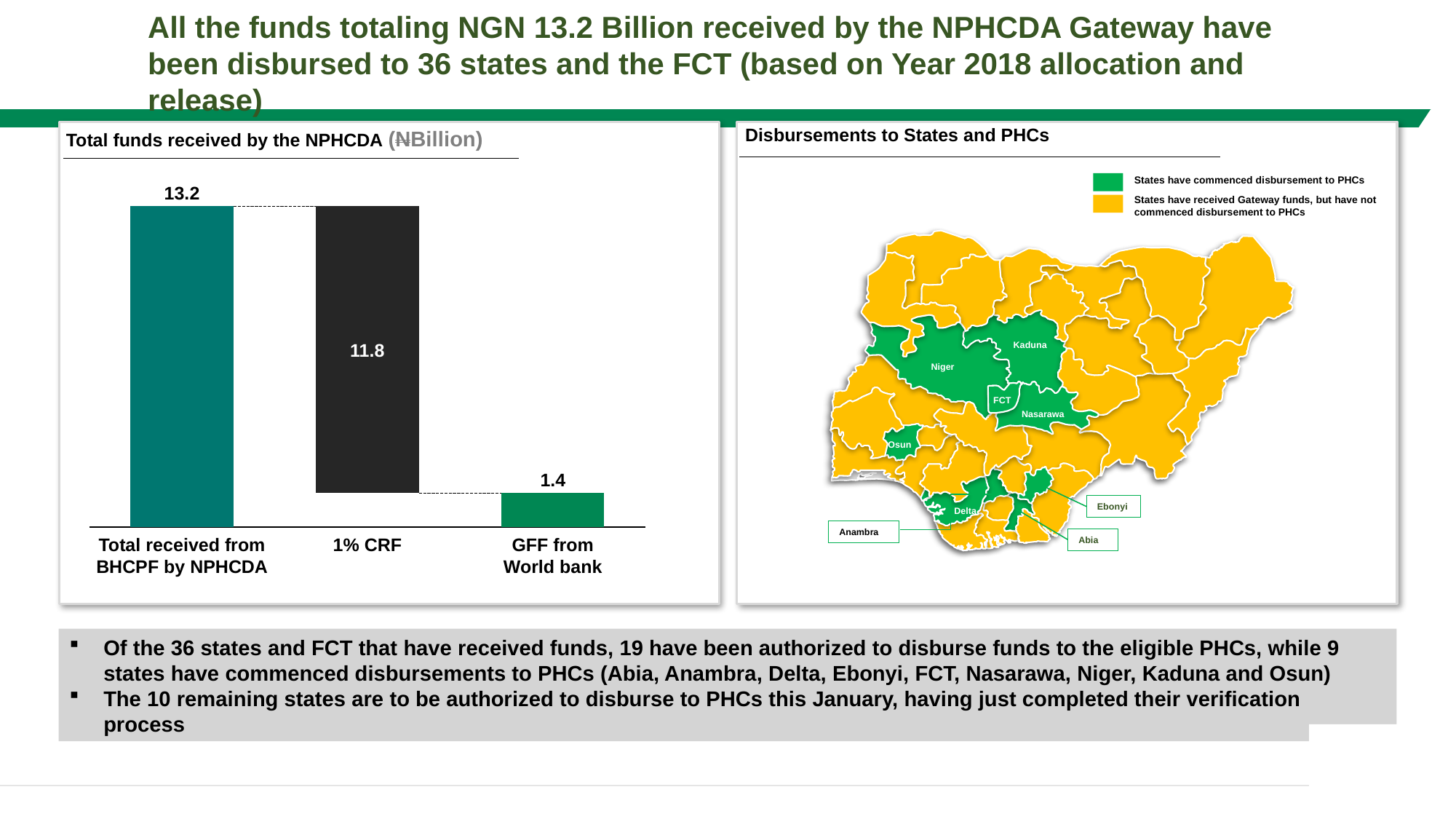
In the 'Total funds received by the NPHCDA' chart, do the values rise or fall from left to right? Fall In the 'Total funds received by the NPHCDA' chart, which is larger: '1% CRF' or 'GFF from World bank'? 1% CRF What kind of chart is 'Total funds received by the NPHCDA'? Bar chart In the 'Total funds received by the NPHCDA' chart, what is the value for 'Total received from BHCPF by NPHCDA'? 13.2 In the 'Total funds received by the NPHCDA' chart, what is the value for 'GFF from World bank'? 1.4 In the 'Total funds received by the NPHCDA' chart, which category has the lowest value? GFF from World bank In the 'Total funds received by the NPHCDA' chart, what is the difference between the '1% CRF' value and the 'GFF from World bank' value? 10.4 How many bars are shown in the 'Total funds received by the NPHCDA' chart? 3 In the 'Total funds received by the NPHCDA' chart, what unit is given in the chart title? ₦Billion In the 'Disbursements to States and PHCs' map, what does the green colour indicate according to the legend? States have commenced disbursement to PHCs In the 'Total funds received by the NPHCDA' chart, which category has the highest value? Total received from BHCPF by NPHCDA In the 'Total funds received by the NPHCDA' chart, what is the value for '1% CRF'? 11.8